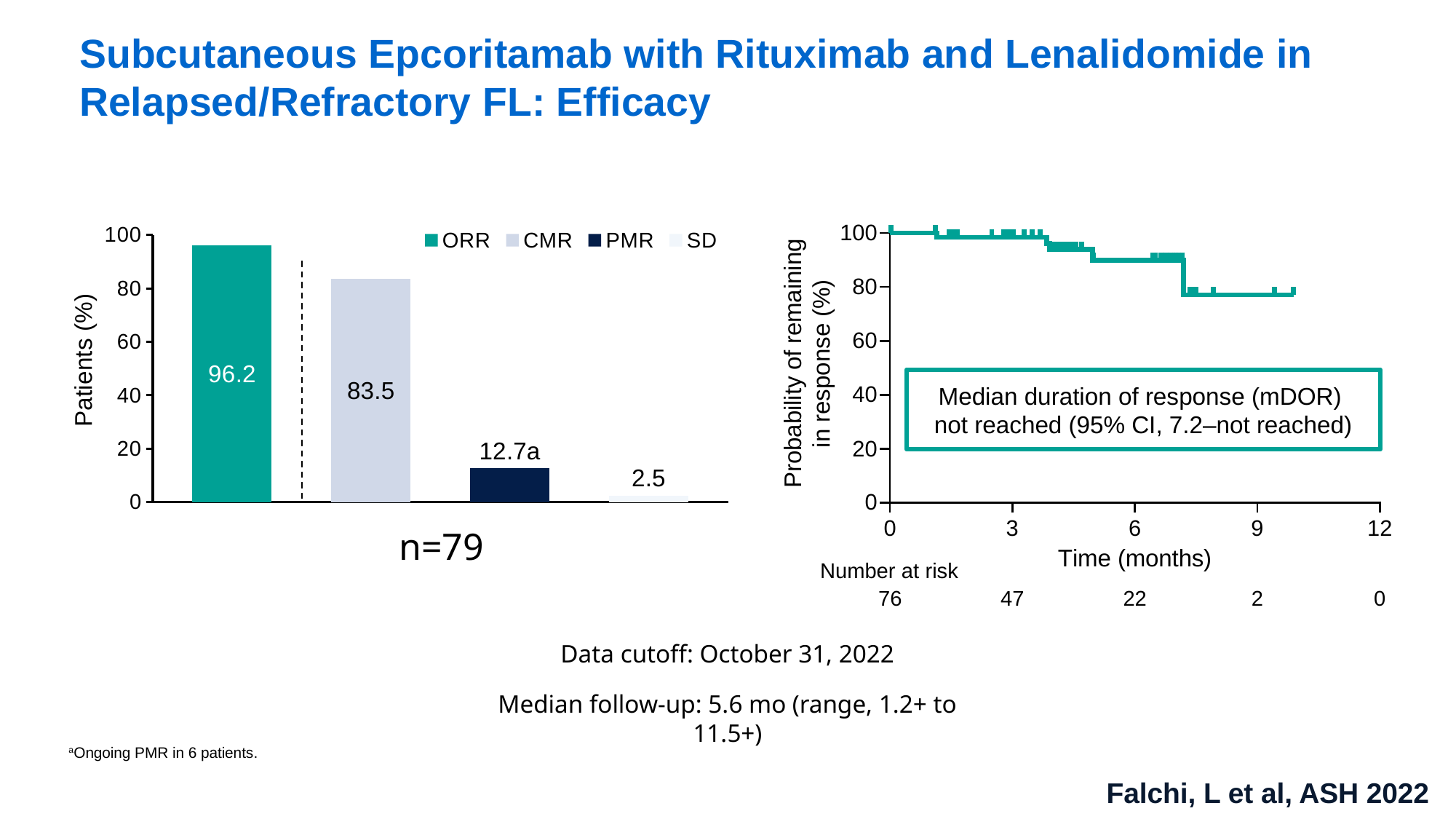
In the bar chart on the left, which category has the highest value? ORR In the Kaplan-Meier chart on the right, is the probability of remaining in response at 9 months greater or less than 80? less In the bar chart on the left, what is the value for CMR? 83.5 In the bar chart on the left, what is the value for ORR? 96.2 What kind of chart is the chart on the left of the slide? Bar chart In the bar chart on the left, what is the difference between the ORR and CMR values? 12.7 In the bar chart on the left, which category has the lowest value? SD In the bar chart on the left, what is the value for SD? 2.5 How many series does the legend of the bar chart on the left list? 4 In the bar chart on the left, which is larger, the CMR value or the PMR value? CMR In the Kaplan-Meier chart on the right, how many patients are at risk at 6 months? 22 In the Kaplan-Meier chart on the right, does the probability of remaining in response rise or fall as time increases? Fall